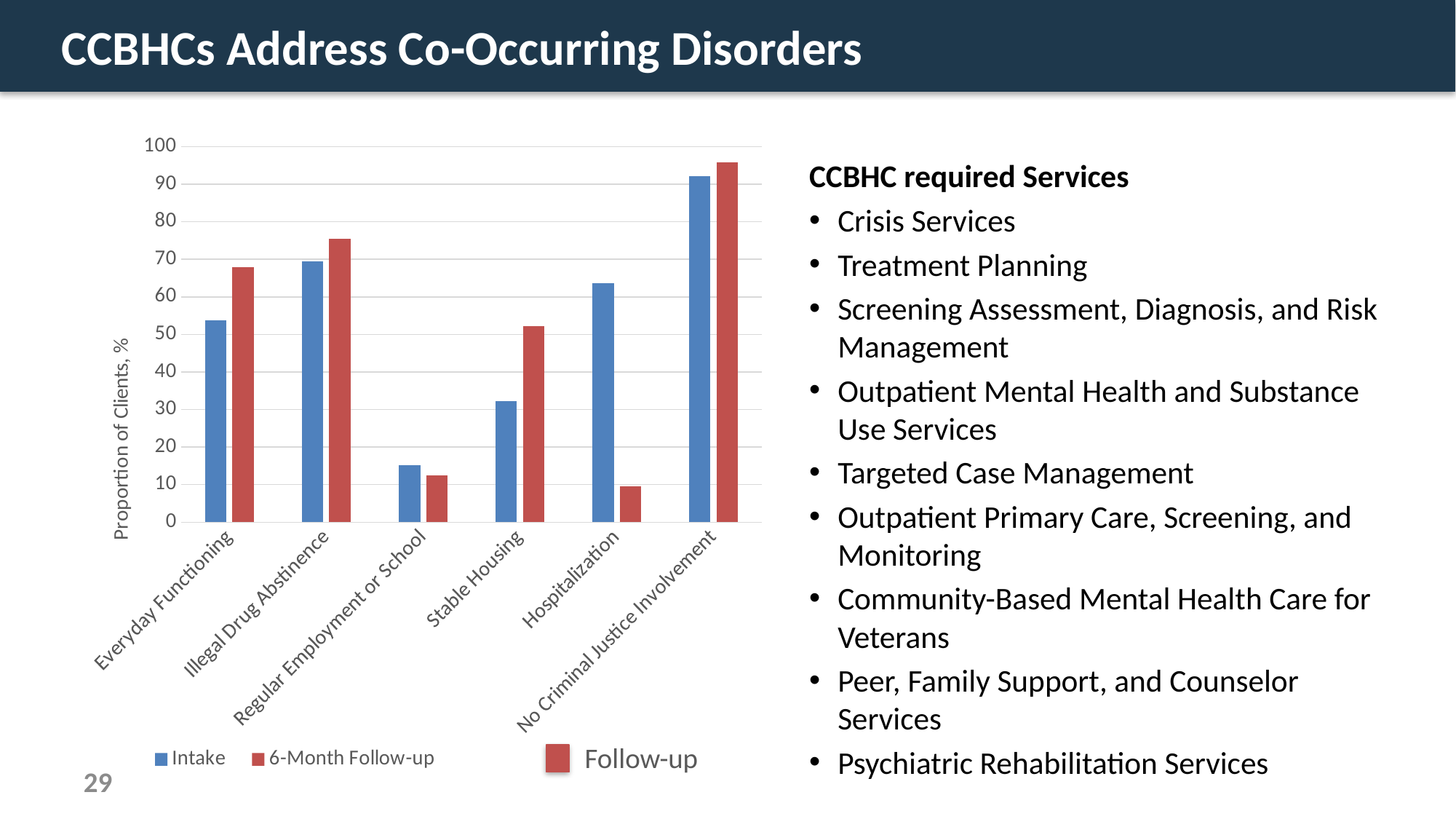
What kind of chart is shown on the slide? Bar chart For Hospitalization, which is larger: the Intake value or the 6-Month Follow-up value? Intake Which category has the lowest Intake value? Regular Employment or School For Stable Housing, which is larger: the Intake value or the 6-Month Follow-up value? 6-Month Follow-up Is the Intake value for Everyday Functioning greater or less than 50? greater What is the label on the vertical axis of the chart? Proportion of Clients, % How many series does the chart legend list? 2 What are the two series named in the chart legend? Intake and 6-Month Follow-up How many categories are shown on the x axis of the chart? 6 Is the 6-Month Follow-up value for Hospitalization greater or less than 20? less Which category has the highest Intake value? No Criminal Justice Involvement Which category has the lowest 6-Month Follow-up value? Hospitalization